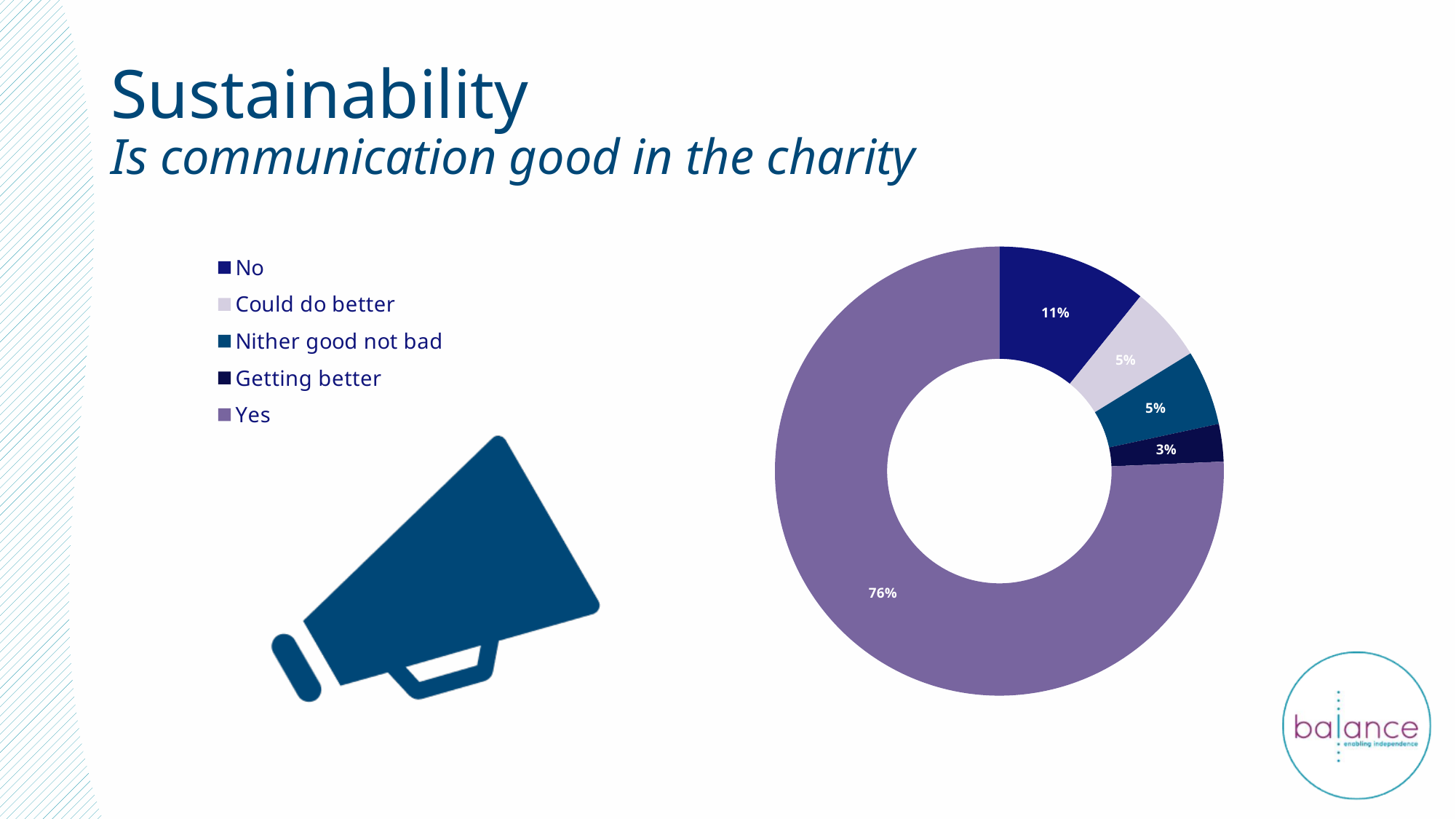
What percentage of respondents answered "No"? 11% What kind of chart is shown on the slide? Pie chart (doughnut) What percentage of respondents answered "Getting better"? 3% What is the combined share of "Could do better" and "Nither good not bad"? 10% What is the difference in percentage points between the "Yes" and "No" shares? 65 Which response category has the smallest share of the chart? Getting better What percentage of respondents answered "Could do better"? 5% Which response category has the largest share of the chart? Yes What percentage of respondents answered "Yes" to whether communication is good in the charity? 76% How many response categories does the chart show? 5 Which legend entry is shown in the light lavender colour? Could do better Which is larger, the share for "No" or the share for "Nither good not bad"? No